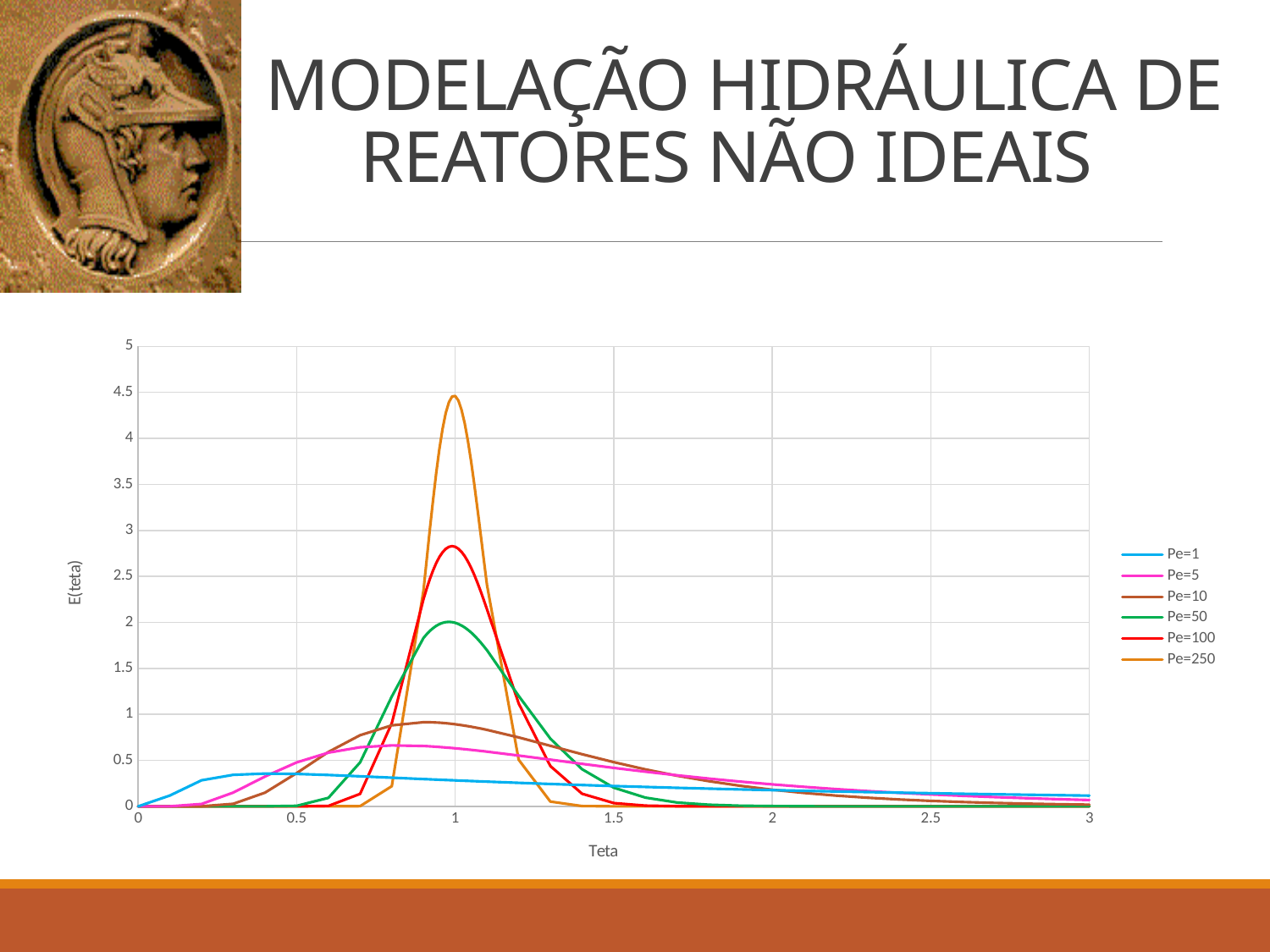
Which series has the lowest peak value of E(teta)? Pe=1 What is the title of the x axis? Teta Does the Pe=250 series rise or fall as Teta increases from 1 to 1.5? fall Is the peak value of the Pe=250 series greater or less than 4? greater Which series has a higher peak, Pe=100 or Pe=50? Pe=100 Is the peak value of the Pe=50 series greater or less than 1.5? greater Which series reaches the highest peak value of E(teta)? Pe=250 Is the peak value of the Pe=10 series greater or less than 1? less What is the title of the y axis? E(teta) How many series does the legend list? 6 What kind of chart is shown on the slide? line chart